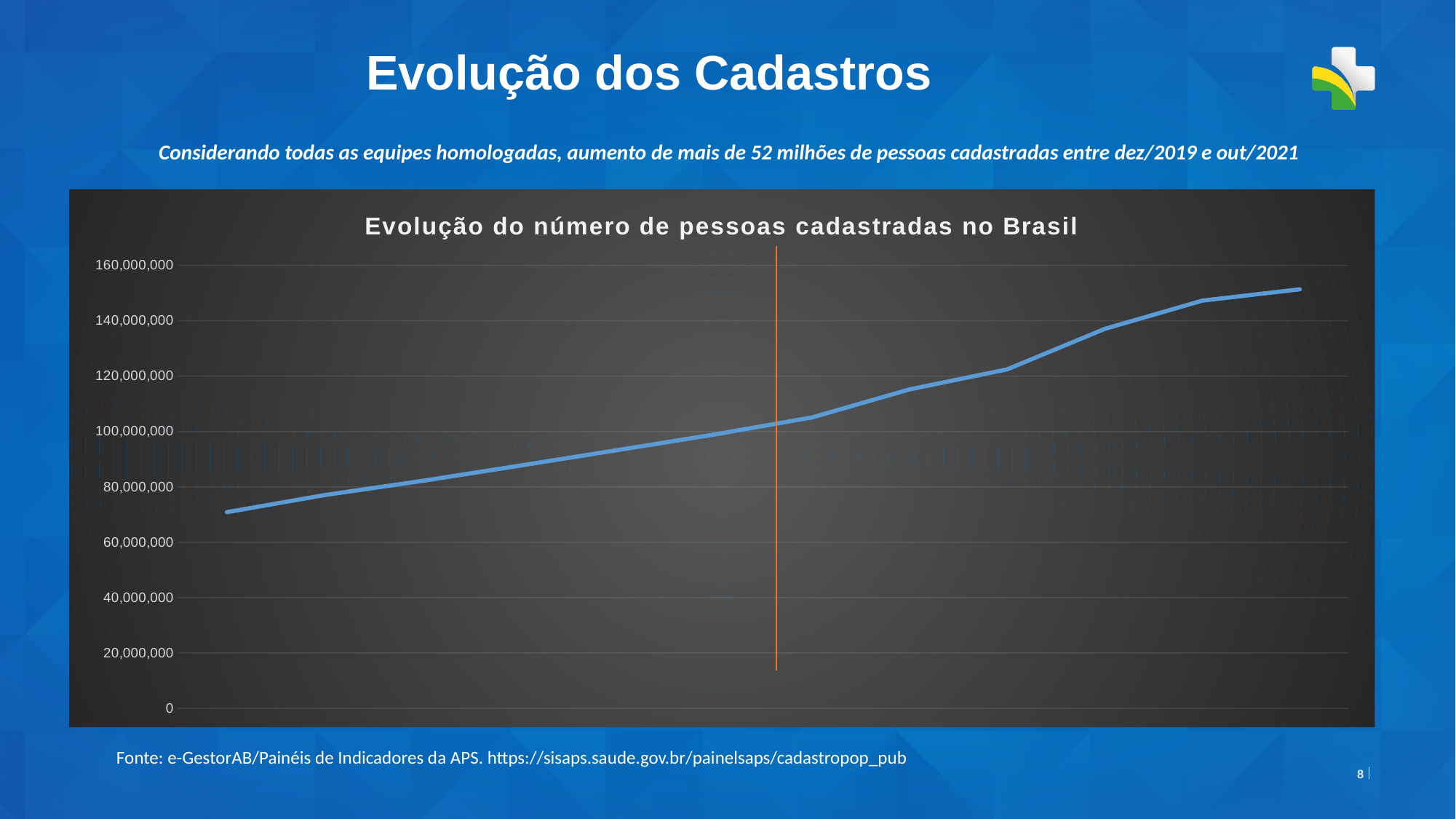
Which point on the line has the lowest value, the leftmost or the rightmost? the leftmost Which point on the line has the highest value, the leftmost or the rightmost? the rightmost Is the value at the leftmost point of the line greater or less than 80,000,000? less What kind of chart is shown on the slide? line chart Do the values in the chart rise or fall from left to right? rise Is the value at the rightmost point of the line greater or less than 160,000,000? less Is the value at the leftmost point of the line greater or less than 60,000,000? greater What is the highest value shown on the vertical axis? 160,000,000 What is the title of the chart? Evolução do número de pessoas cadastradas no Brasil